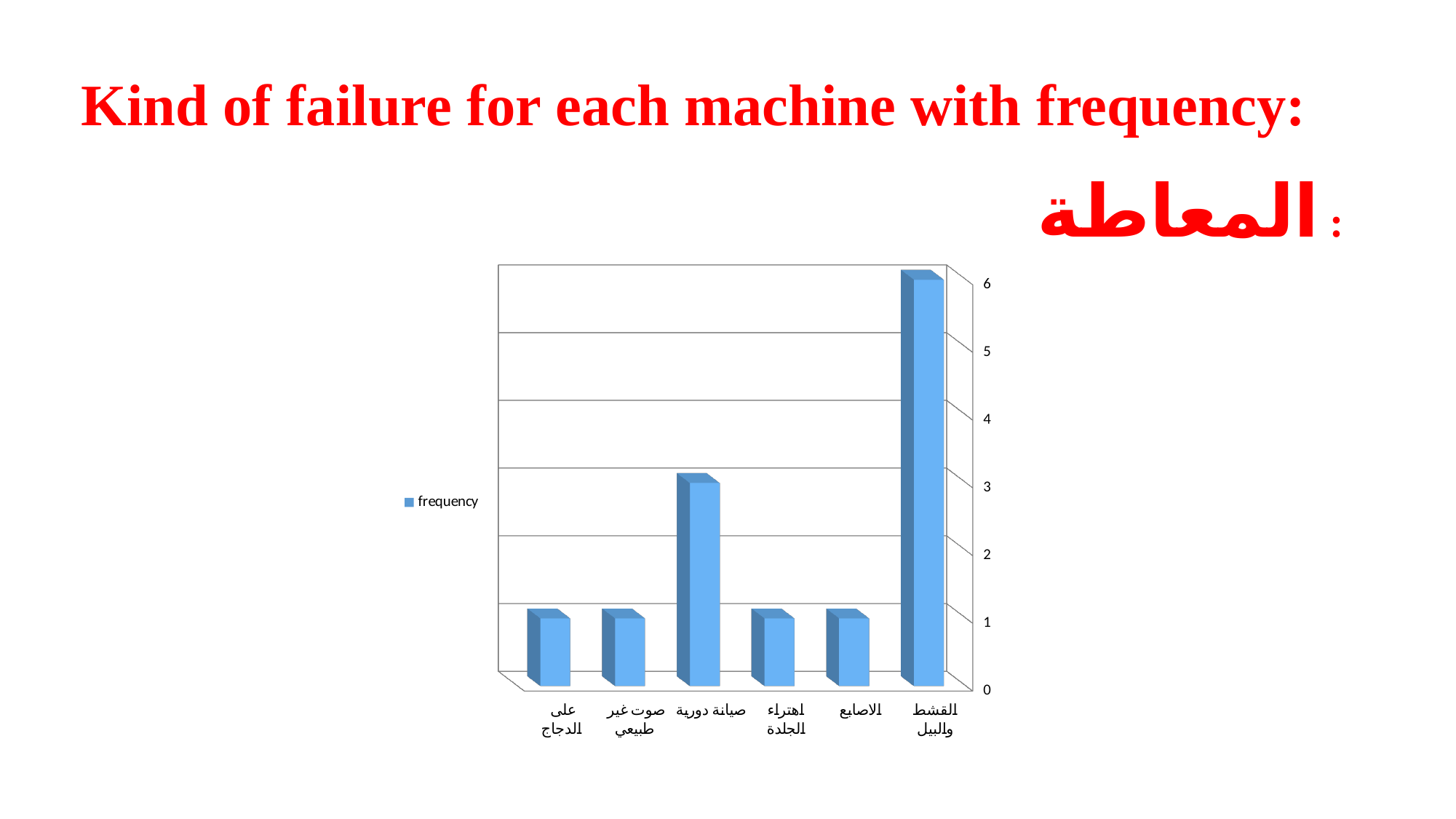
How many series does the chart legend list? 1 What is the frequency for الاصابع? 1 What is the difference in frequency between القشط والبيل and صيانة دورية? 3 How many categories are shown on the x axis of the chart? 6 What is the frequency for القشط والبيل? 6 What is the name of the series shown in the chart legend? frequency Which has a higher frequency, صيانة دورية or اهتراء الجلدة? صيانة دورية What type of chart is shown on the slide? bar chart What is the frequency for صيانة دورية? 3 Which category has the highest frequency? القشط والبيل How many categories have a frequency of 1? 4 Is the frequency for القشط والبيل greater or less than 5? greater